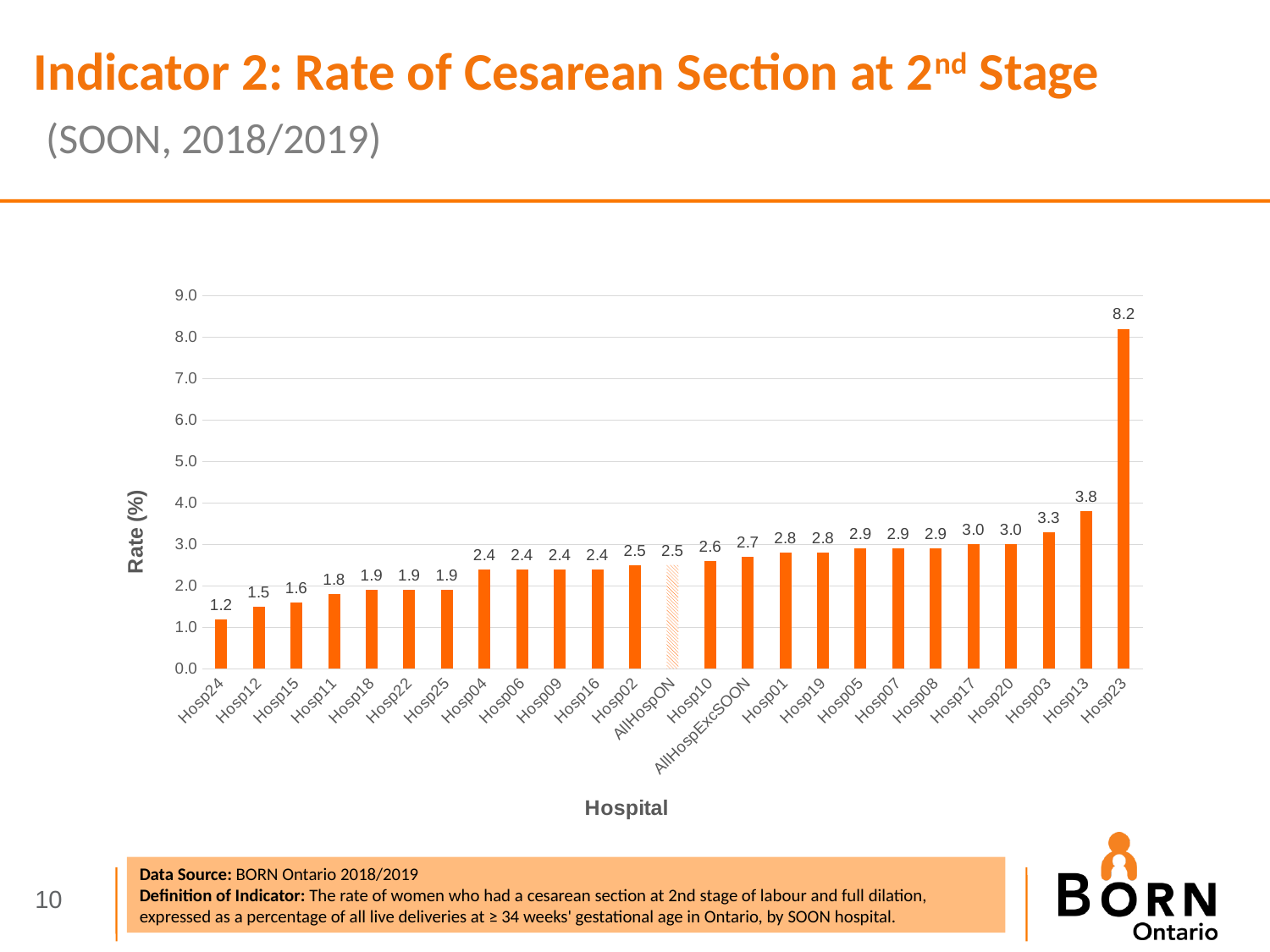
What is the difference between the rate for AllHospExcSOON and the rate for AllHospON? 0.2 What is the rate for AllHospExcSOON? 2.7 Which hospital has the highest rate of cesarean section at 2nd stage? Hosp23 What is the rate for Hosp23? 8.2 What type of chart is shown on the slide? Bar chart Is the value for Hosp23 greater or less than 8.0? greater What is the difference between the rate for Hosp23 and the rate for Hosp13? 4.4 What is the rate for Hosp13? 3.8 What is the rate for AllHospON? 2.5 How many bars are plotted on the chart? 25 Which has a higher rate, Hosp03 or Hosp12? Hosp03 Which hospital has the lowest rate of cesarean section at 2nd stage? Hosp24